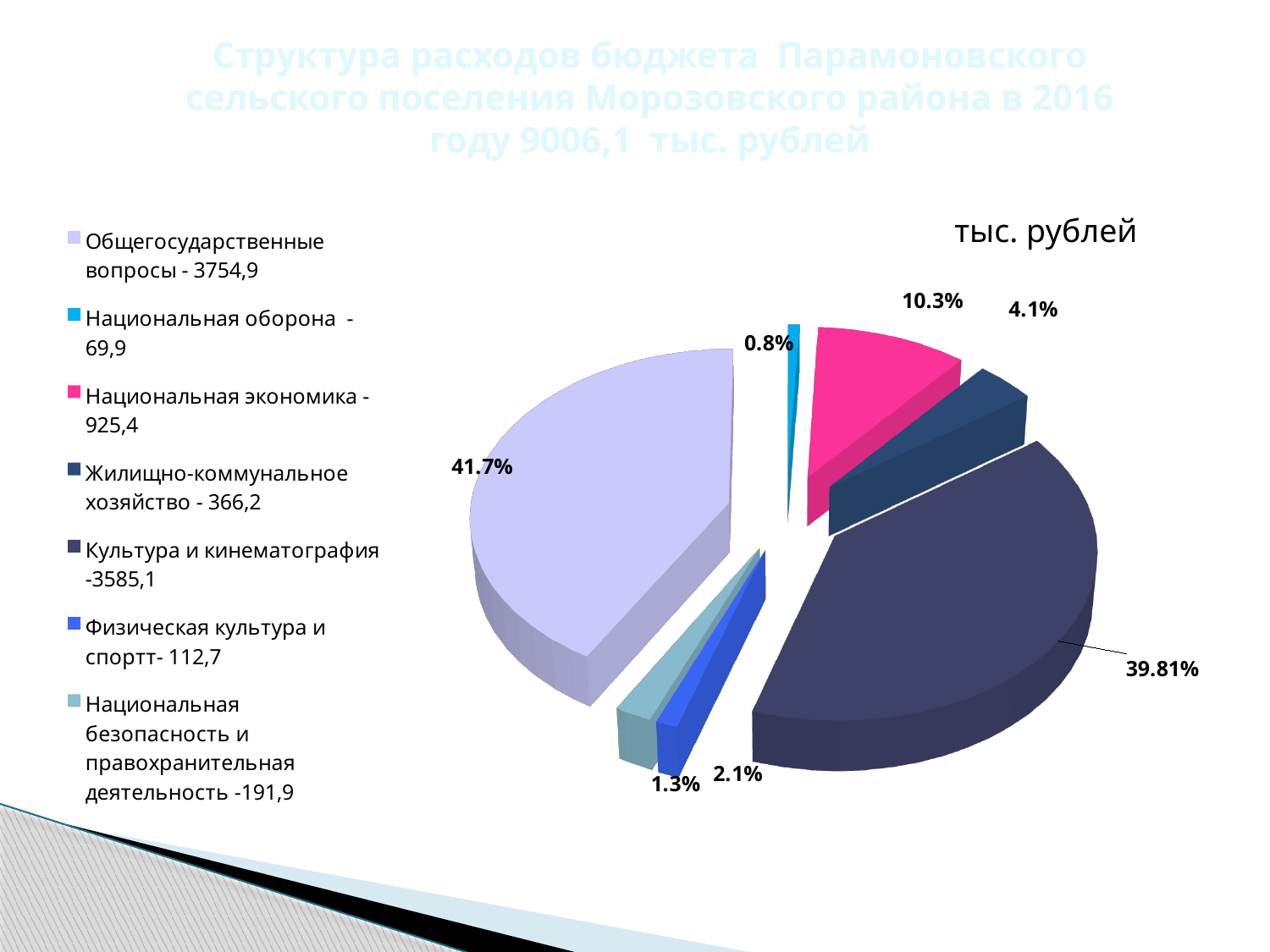
Which slice is larger: Национальная экономика or Жилищно-коммунальное хозяйство? Национальная экономика Which category has the largest slice of the pie? Общегосударственные вопросы What share of the pie is labelled for Культура и кинематография? 39.81% How many slices does the pie chart have? 7 What kind of chart is shown on the slide? pie chart What share of the pie is labelled for Национальная экономика? 10.3% What share of the pie is labelled for Жилищно-коммунальное хозяйство? 4.1% What value in тыс. рублей does the legend give for Культура и кинематография? 3585,1 Which category has the smallest slice of the pie? Национальная оборона What is the difference in percentage points between the Национальная экономика slice and the Жилищно-коммунальное хозяйство slice? 6.2%